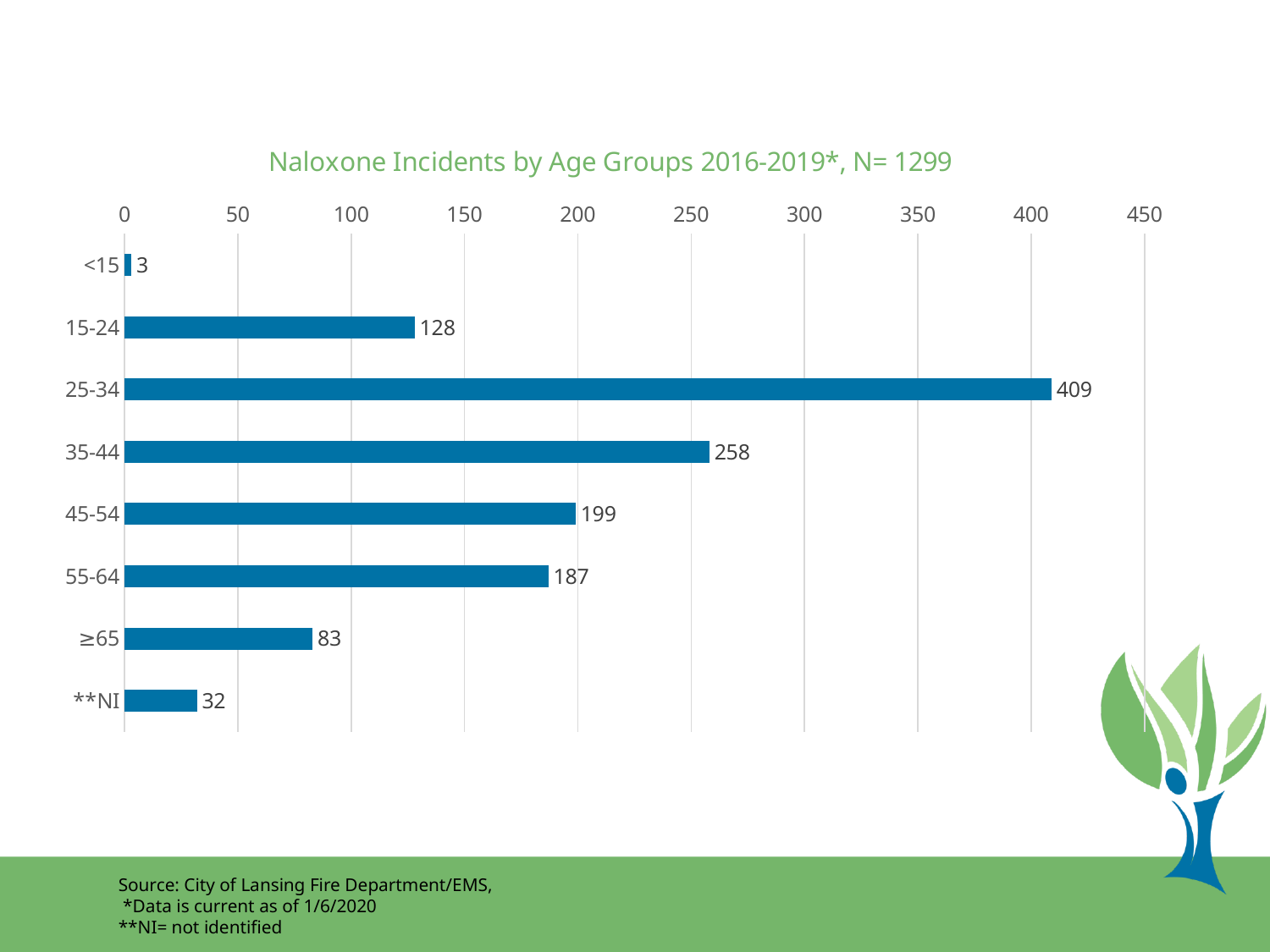
Which is larger, the value for 15-24 or the value for ≥65? 15-24 Which category has the lowest value? <15 What is the value for the 55-64 age group? 187 How many categories are shown on the chart? 8 Is the value for 35-44 greater or less than 250? greater What is the difference between the values for 45-54 and 55-64? 12 What is the title of the chart? Naloxone Incidents by Age Groups 2016-2019*, N= 1299 What is the value for the 25-34 age group? 409 What is the difference between the values for 25-34 and 35-44? 151 What kind of chart is shown on the slide? Bar chart What is the value for the **NI category? 32 Which age group has the highest number of naloxone incidents? 25-34